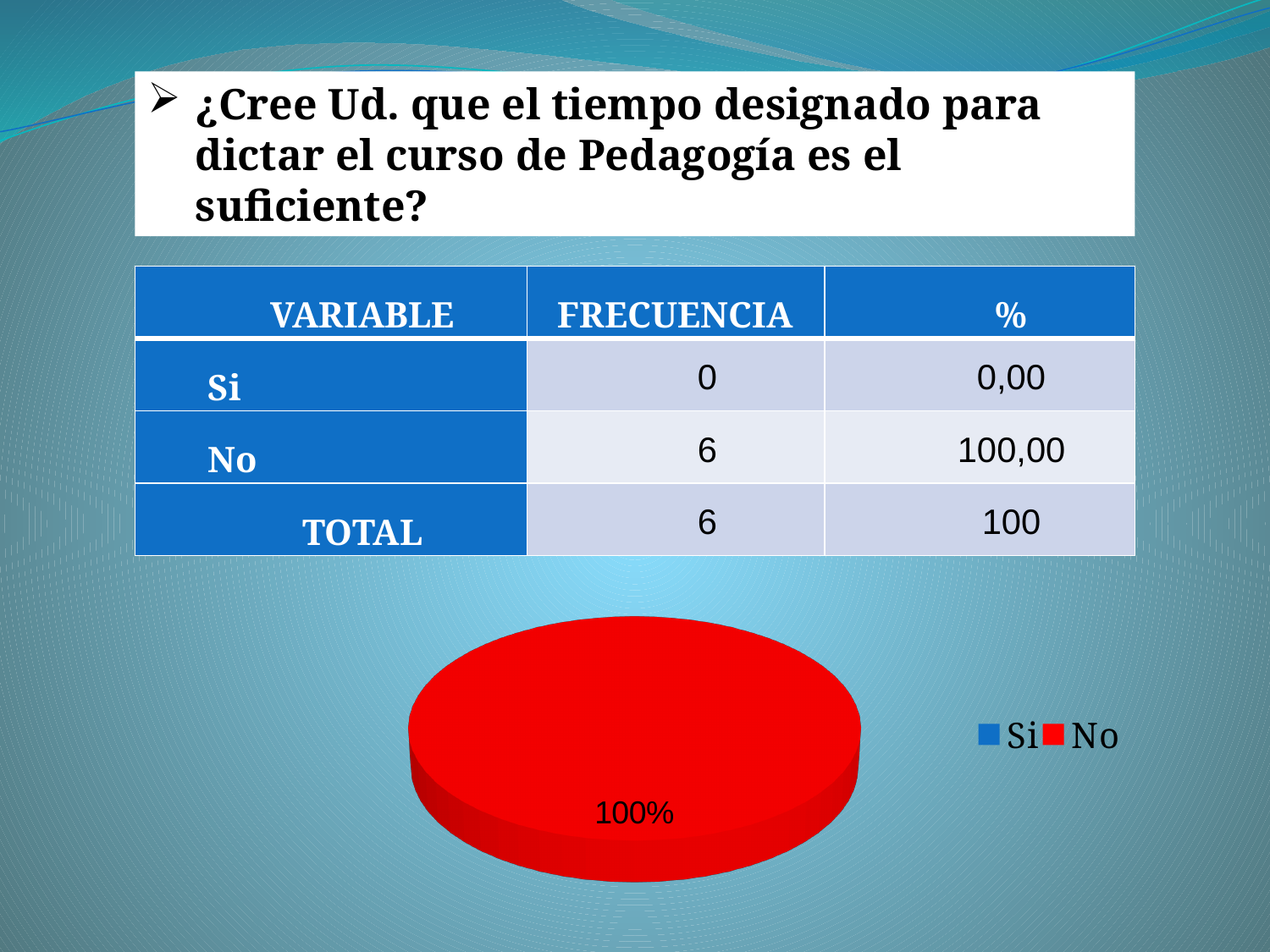
Which is larger in the pie chart, Si or No? No What kind of chart is shown on the slide? pie chart What colour does the legend assign to Si? blue How many entries does the chart legend list? 2 Which category has the largest slice in the pie chart? No What is the data label printed on the pie chart? 100% What share of the pie does the No slice represent? 100% Which category has the smallest share in the pie chart? Si What colour is the No slice in the pie chart? red